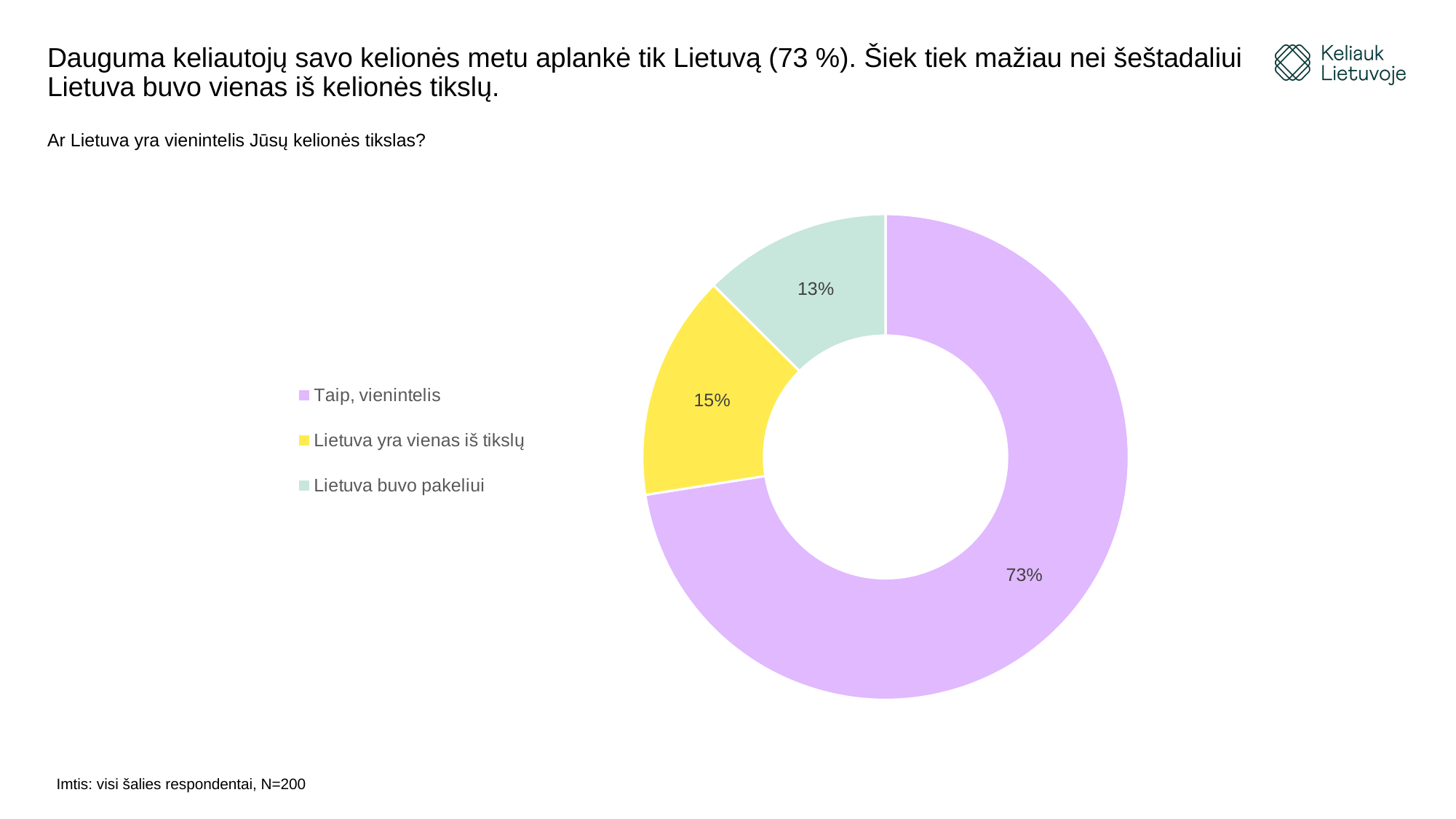
What share of respondents answered "Lietuva yra vienas iš tikslų"? 15% What is the sample size stated at the bottom of the slide? N=200 What share of respondents answered "Lietuva buvo pakeliui"? 13% What share of respondents answered "Taip, vienintelis"? 73% What is the difference in percentage points between "Lietuva yra vienas iš tikslų" and "Lietuva buvo pakeliui"? 2 What kind of chart is shown on the slide? Pie chart (doughnut) How many categories does the pie chart show? 3 Which is larger: the share for "Taip, vienintelis" or the share for "Lietuva buvo pakeliui"? Taip, vienintelis Which answer category has the smallest share of the pie? Lietuva buvo pakeliui What is the difference in percentage points between "Taip, vienintelis" and "Lietuva yra vienas iš tikslų"? 58 What colour is the slice for "Lietuva yra vienas iš tikslų"? Yellow Which answer category has the largest share of the pie? Taip, vienintelis